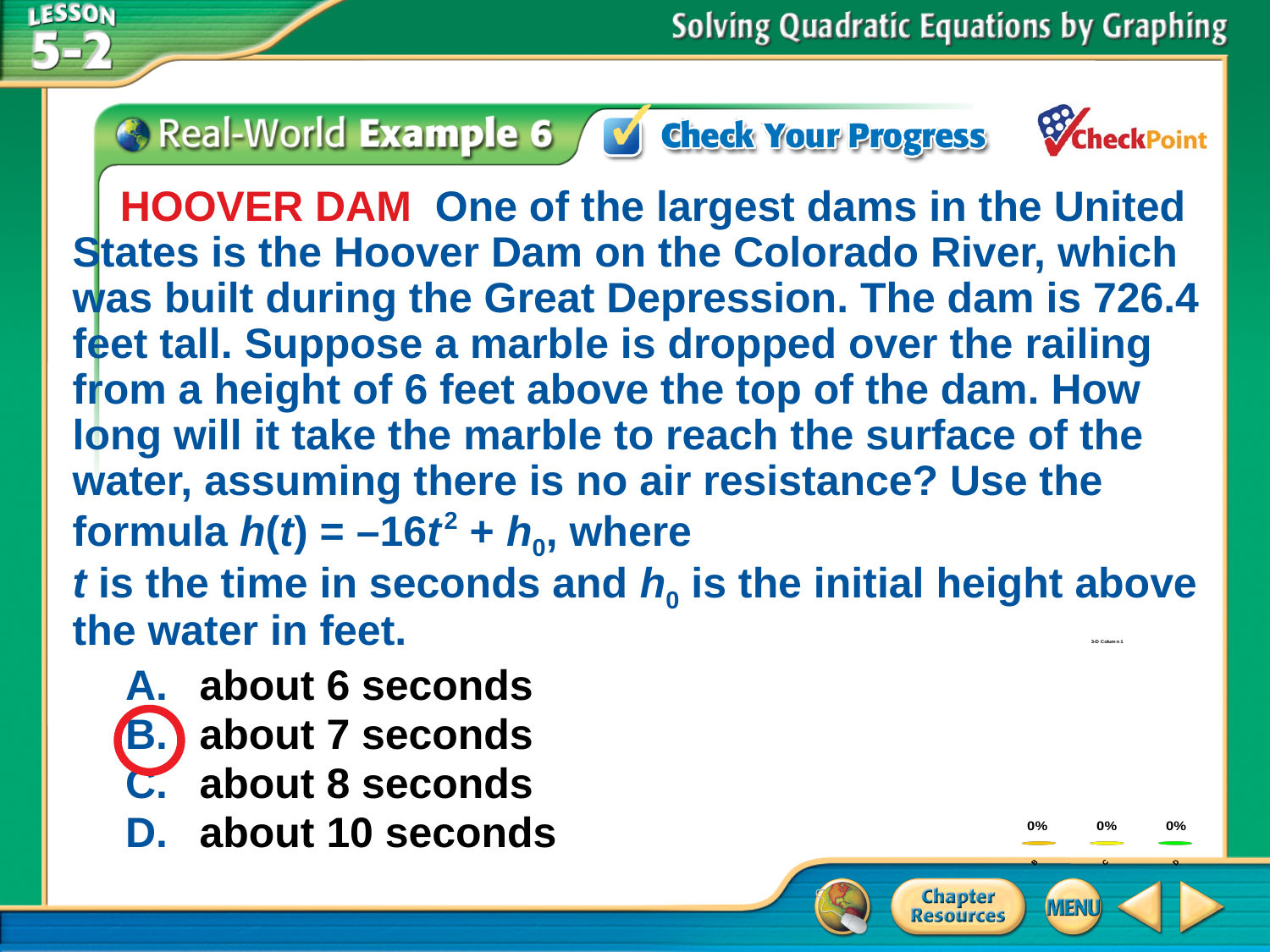
What is the difference between the values of the leftmost and rightmost bars in the small chart in the bottom-right corner? 0% What value is printed above the rightmost bar of the small chart in the bottom-right corner? 0% What value is printed above the leftmost bar of the small chart in the bottom-right corner? 0% What kind of chart is shown in the bottom-right corner of the slide? bar chart What value is printed above the middle bar of the small chart in the bottom-right corner? 0% How many bars does the small chart in the bottom-right corner of the slide show? 3